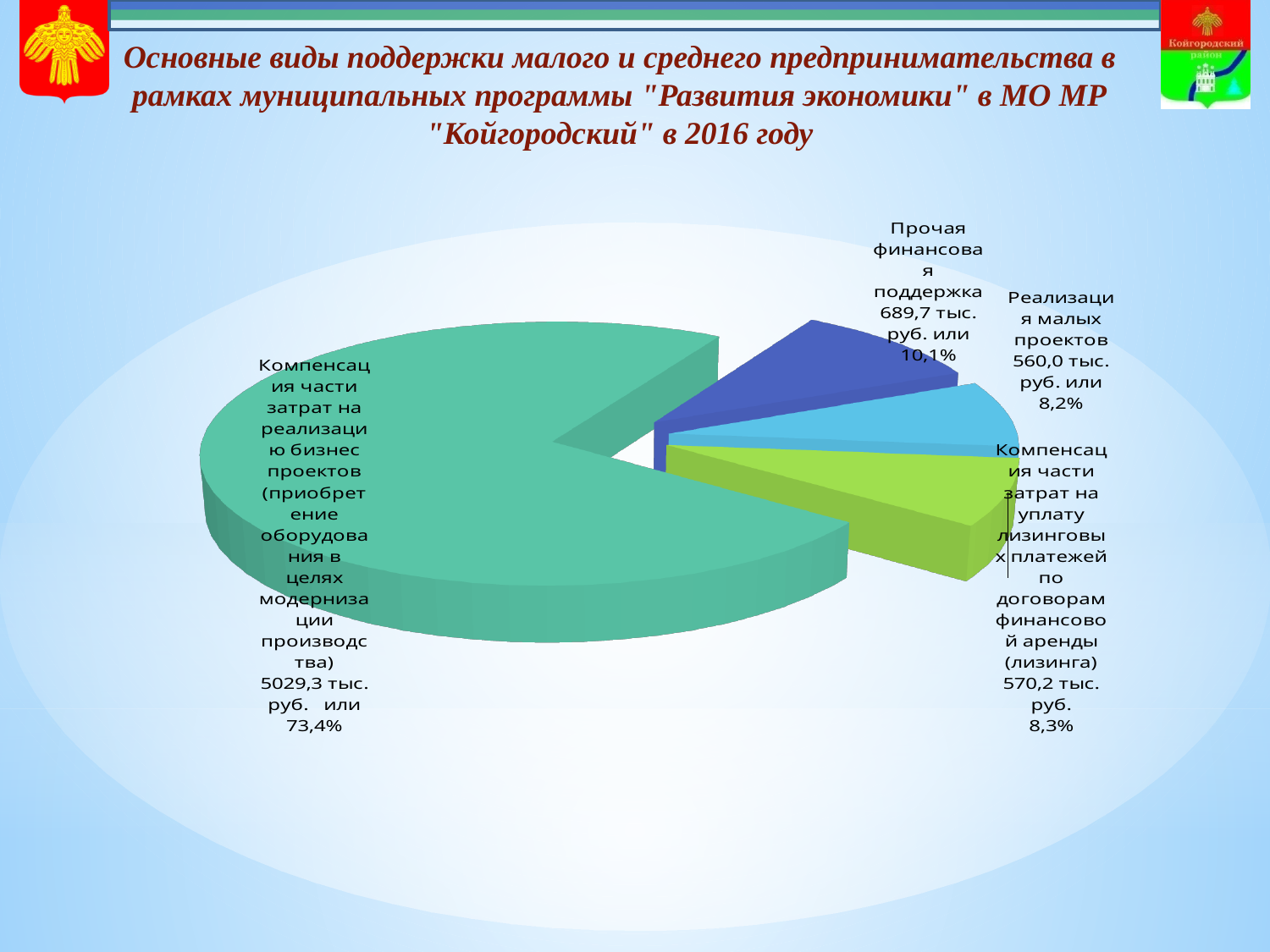
What is the difference in value between "Прочая финансовая поддержка" and "Компенсация части затрат на уплату лизинговых платежей"? 119,5 тыс. руб. What is the value for "Компенсация части затрат на реализацию бизнес проектов (приобретение оборудования в целях модернизации производства)"? 5029,3 тыс. руб. Which category has the largest slice of the pie? Компенсация части затрат на реализацию бизнес проектов (приобретение оборудования в целях модернизации производства) Which category has the smallest slice of the pie? Реализация малых проектов Which is larger: the value for "Компенсация части затрат на уплату лизинговых платежей" or for "Реализация малых проектов"? Компенсация части затрат на уплату лизинговых платежей How many slices does the pie chart have? 4 What is the value for "Прочая финансовая поддержка"? 689,7 тыс. руб. What kind of chart is shown on the slide? Pie chart What share of the pie does "Компенсация части затрат на реализацию бизнес проектов" represent? 73,4% What share of the pie does "Прочая финансовая поддержка" represent? 10,1% What is the value for "Реализация малых проектов"? 560,0 тыс. руб. What is the value for "Компенсация части затрат на уплату лизинговых платежей по договорам финансовой аренды (лизинга)"? 570,2 тыс. руб.